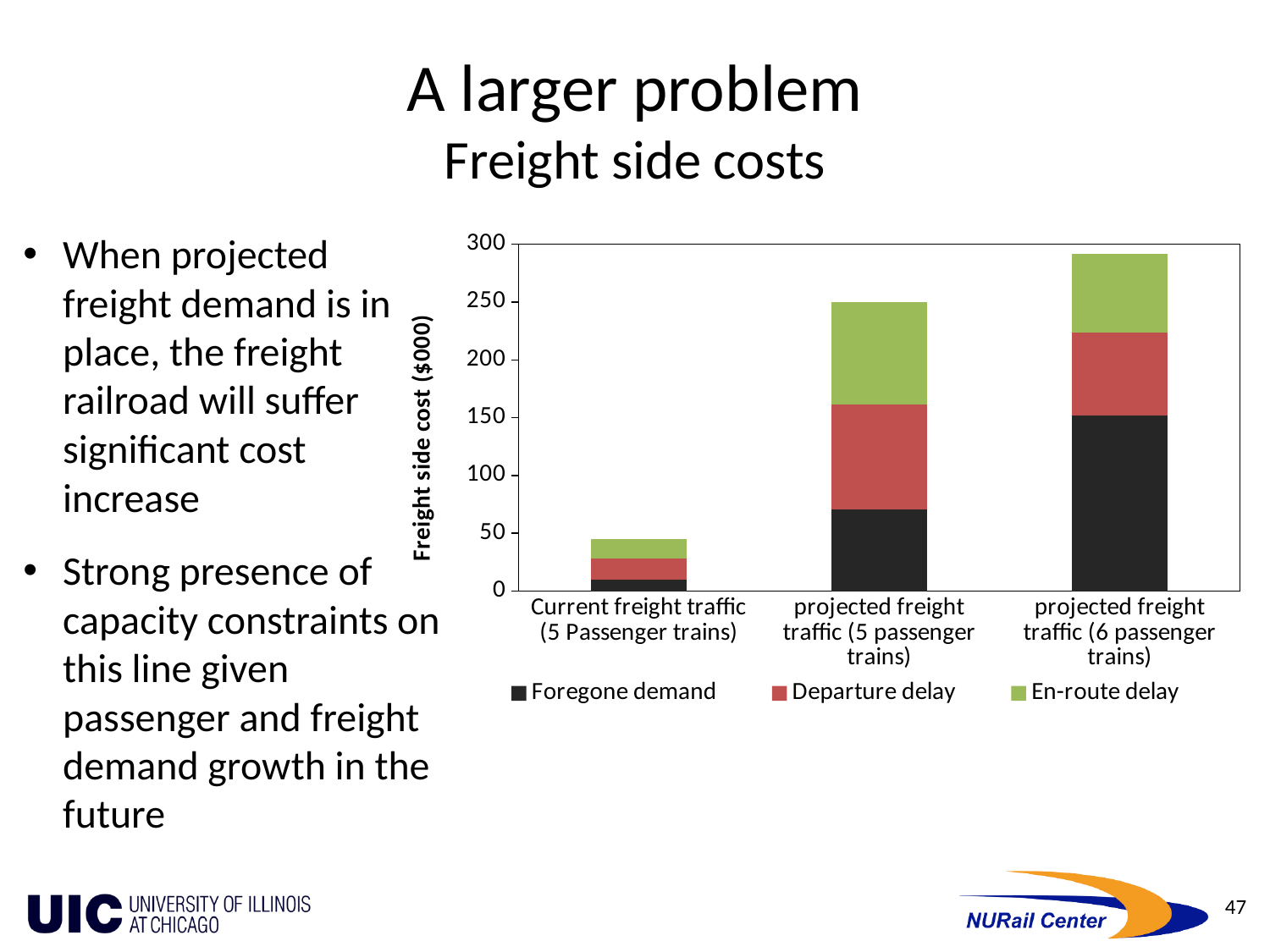
Do the total freight side costs rise or fall from left to right across the categories? rise Which category has the highest total freight side cost? projected freight traffic (6 passenger trains) Which has the larger Foregone demand value: projected freight traffic (5 passenger trains) or projected freight traffic (6 passenger trains)? projected freight traffic (6 passenger trains) Is the total freight side cost for Current freight traffic (5 Passenger trains) greater or less than 50? less What is the title of the chart's vertical axis? Freight side cost ($000) How many series does the chart's legend list? 3 Is the total freight side cost for projected freight traffic (6 passenger trains) greater or less than 250? greater What kind of chart is shown on the slide? Stacked bar chart Which category has the lowest total freight side cost? Current freight traffic (5 Passenger trains) Is the Foregone demand value for projected freight traffic (6 passenger trains) greater or less than 100? greater How many categories are shown on the x axis of the chart? 3